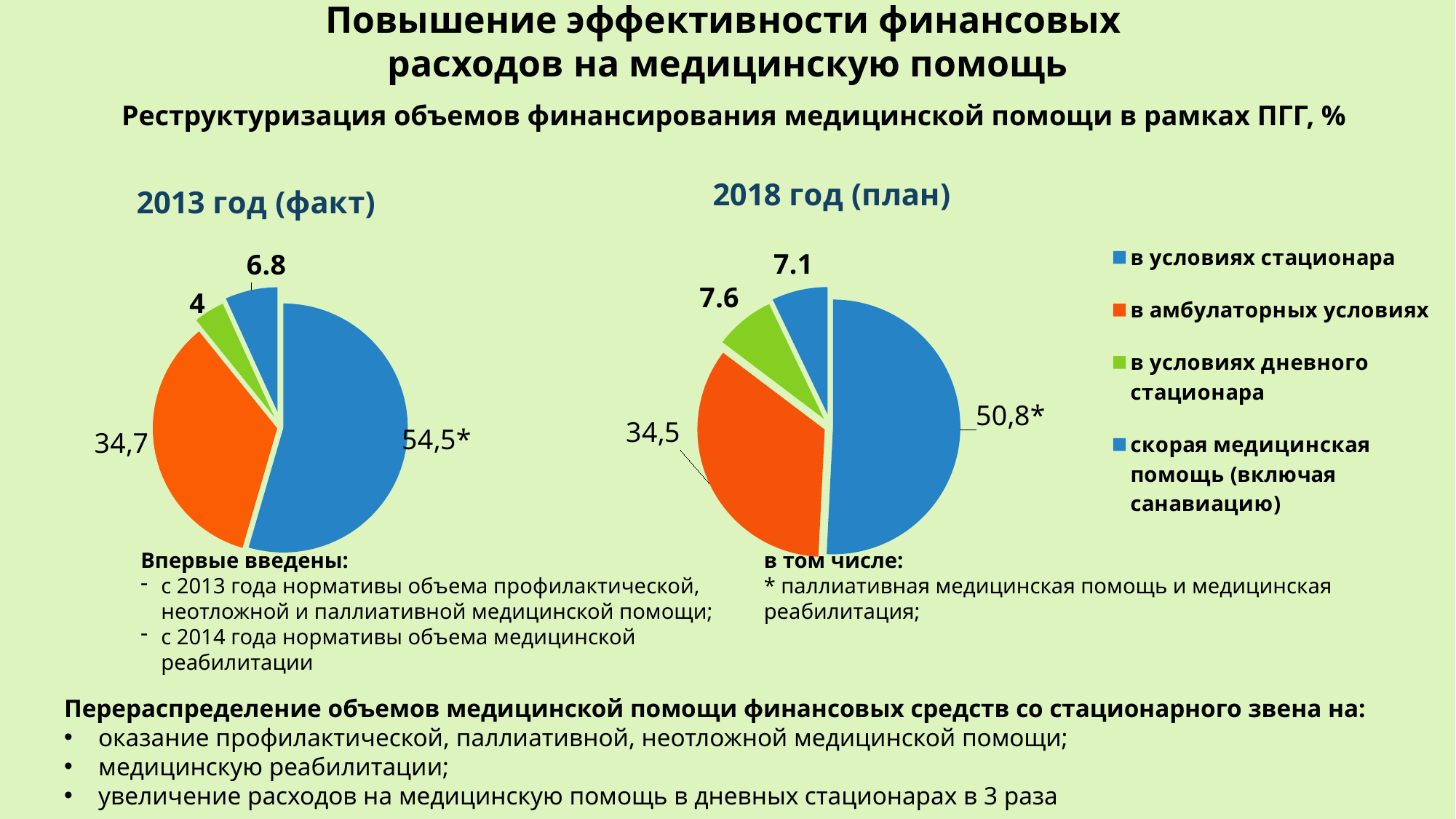
In the '2018 год (план)' chart, what is the value of the largest slice? 50,8* What kind of charts are shown on the slide? Pie charts In the '2013 год (факт)' chart, what is the value for 'в амбулаторных условиях'? 34,7 Which is larger: the 'в амбулаторных условиях' value in the '2013 год (факт)' chart or in the '2018 год (план)' chart? 2013 год (факт) In the '2013 год (факт)' chart, which category has the smallest slice? в условиях дневного стационара How many slices does the '2018 год (план)' pie chart have? 4 What is the difference between the 'в условиях дневного стационара' values in the '2018 год (план)' and '2013 год (факт)' charts? 3.6 How many entries does the legend list? 4 In the '2013 год (факт)' chart, which category has the largest slice? в условиях стационара In the '2013 год (факт)' chart, what is the value for 'в условиях дневного стационара'? 4 In the '2018 год (план)' chart, what is the value for 'в условиях дневного стационара'? 7.6 In the '2018 год (план)' chart, what is the value for 'в амбулаторных условиях'? 34,5